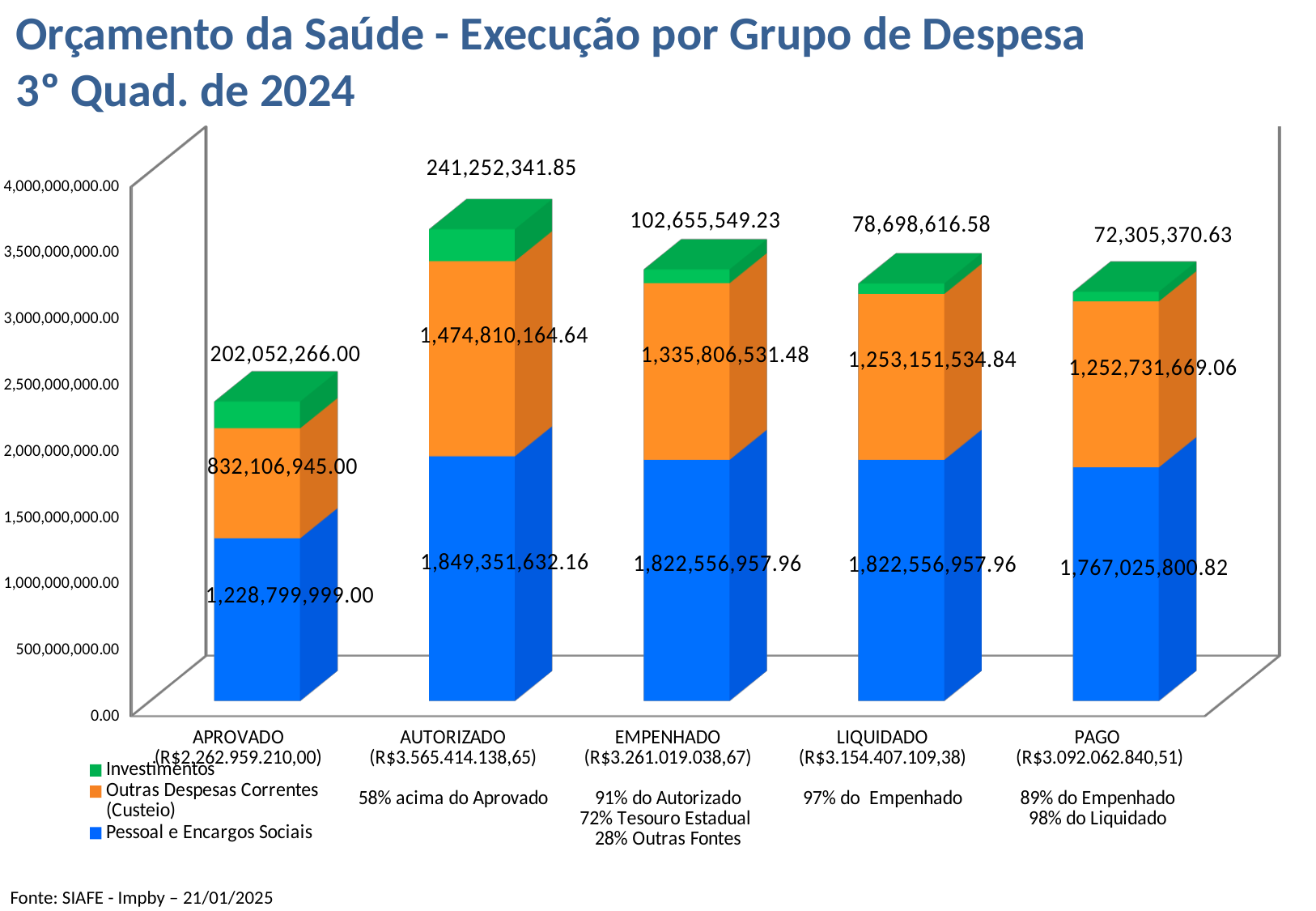
Which category has the lowest value for Pessoal e Encargos Sociais? APROVADO Which category has the highest value for Investimentos? AUTORIZADO What kind of chart is shown on the slide? Stacked bar chart What is the total of the stacked bar for AUTORIZADO? R$3.565.414.138,65 Which is larger: Outras Despesas Correntes (Custeio) for AUTORIZADO or for APROVADO? AUTORIZADO What is the value of Investimentos for AUTORIZADO? 241,252,341.85 What is the difference between the Investimentos values for AUTORIZADO and PAGO? 168,946,971.22 What is the difference between the Pessoal e Encargos Sociais values for AUTORIZADO and APROVADO? 620,551,633.16 How many series does the legend list? 3 What is the value of Pessoal e Encargos Sociais for PAGO? 1,767,025,800.82 How many categories are shown on the x axis? 5 What is the value of Outras Despesas Correntes (Custeio) for EMPENHADO? 1,335,806,531.48